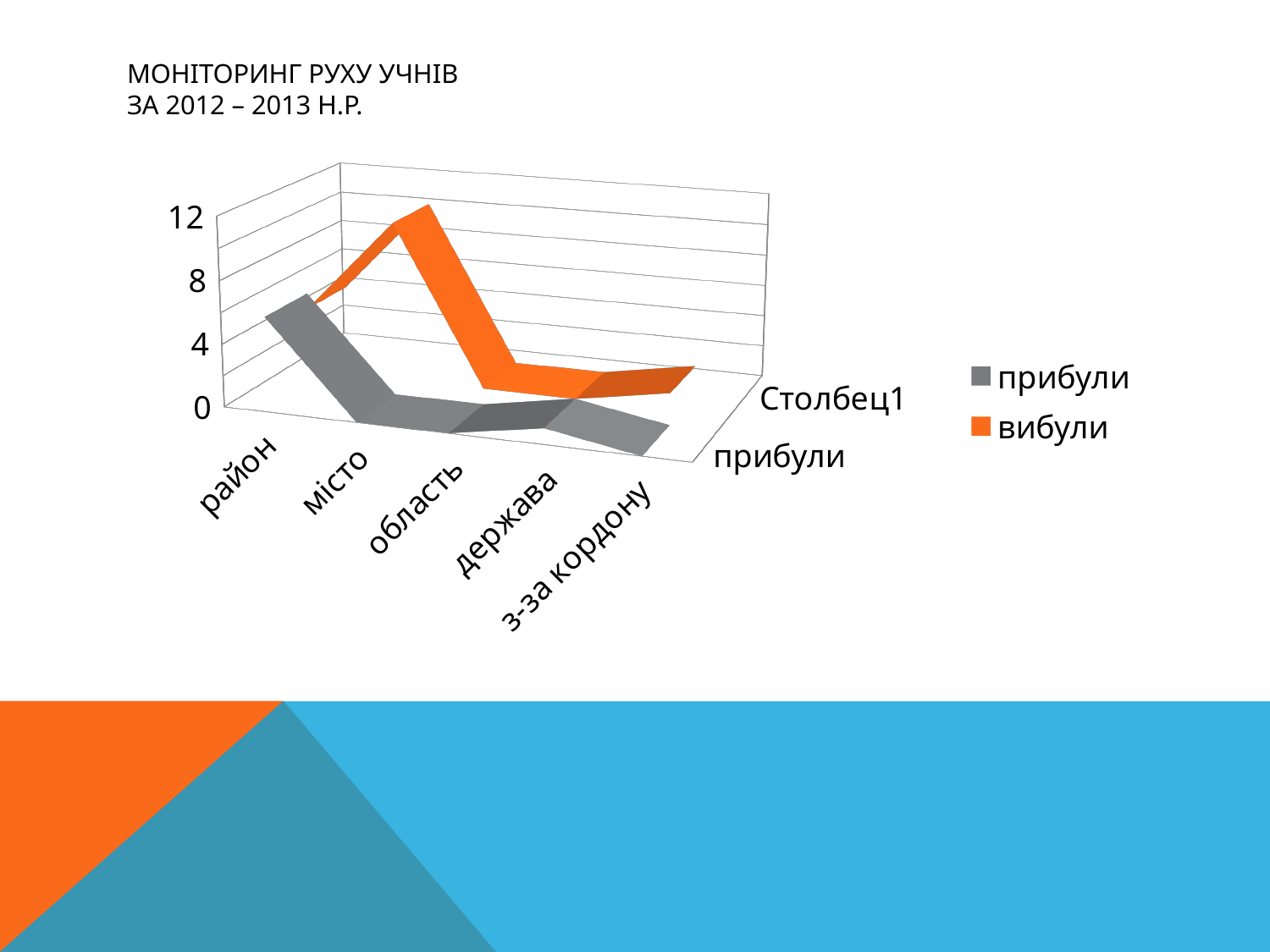
For місто, which series has the larger value, прибули or вибули? вибули Is the value of прибули for держава greater or less than 4? less How many categories are shown on the x axis? 5 Does the value of прибули rise or fall from район to місто? fall Which series is drawn in orange? вибули How many series does the legend list? 2 Does the value of вибули rise or fall from місто to область? fall What kind of chart is shown on the slide? line chart Which series is drawn in gray? прибули For which category is the value of прибули highest? район Is the value of вибули for місто greater or less than 8? greater For which category is the value of вибули highest? місто